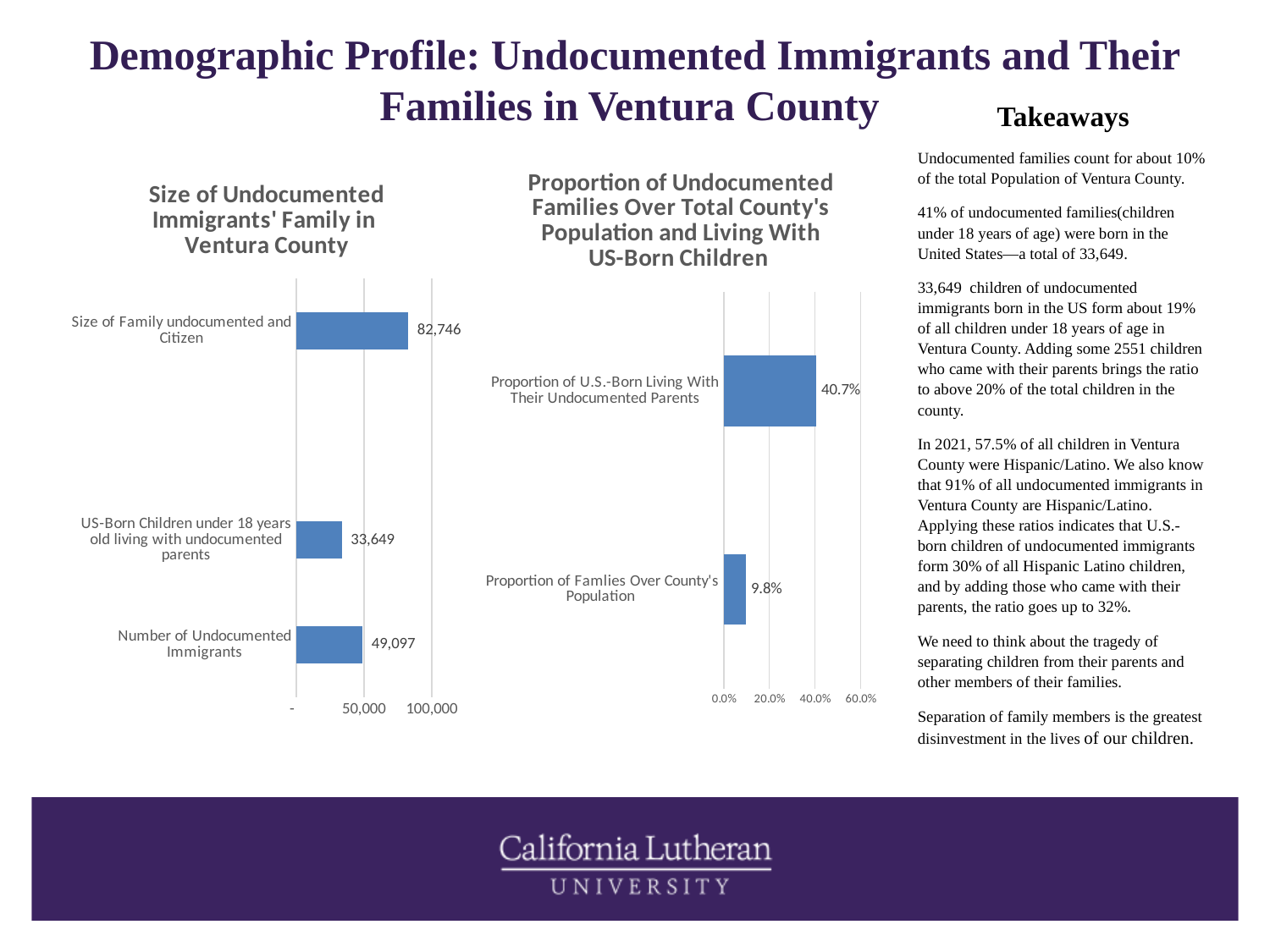
In the chart titled "Proportion of Undocumented Families Over Total County's Population and Living With US-Born Children", which is larger: Proportion of U.S.-Born Living With Their Undocumented Parents or Proportion of Famlies Over County's Population? Proportion of U.S.-Born Living With Their Undocumented Parents In the chart titled "Size of Undocumented Immigrants' Family in Ventura County", what is the value for US-Born Children under 18 years old living with undocumented parents? 33,649 In the chart titled "Proportion of Undocumented Families Over Total County's Population and Living With US-Born Children", what is the difference between the two plotted values? 30.9% What kind of chart is the chart on the right of the slide? bar chart In the chart titled "Size of Undocumented Immigrants' Family in Ventura County", what is the difference between the value for Size of Family undocumented and Citizen and the value for Number of Undocumented Immigrants? 33,649 In the chart titled "Proportion of Undocumented Families Over Total County's Population and Living With US-Born Children", what is the value for Proportion of U.S.-Born Living With Their Undocumented Parents? 40.7% In the chart titled "Size of Undocumented Immigrants' Family in Ventura County", what is the value for Number of Undocumented Immigrants? 49,097 In the chart titled "Size of Undocumented Immigrants' Family in Ventura County", which category has the highest value? Size of Family undocumented and Citizen In the chart titled "Proportion of Undocumented Families Over Total County's Population and Living With US-Born Children", what is the value for Proportion of Famlies Over County's Population? 9.8% In the chart titled "Size of Undocumented Immigrants' Family in Ventura County", is the value for Size of Family undocumented and Citizen greater or less than 50,000? greater In the chart titled "Size of Undocumented Immigrants' Family in Ventura County", how many categories are plotted? 3 In the chart titled "Size of Undocumented Immigrants' Family in Ventura County", which category has the lowest value? US-Born Children under 18 years old living with undocumented parents